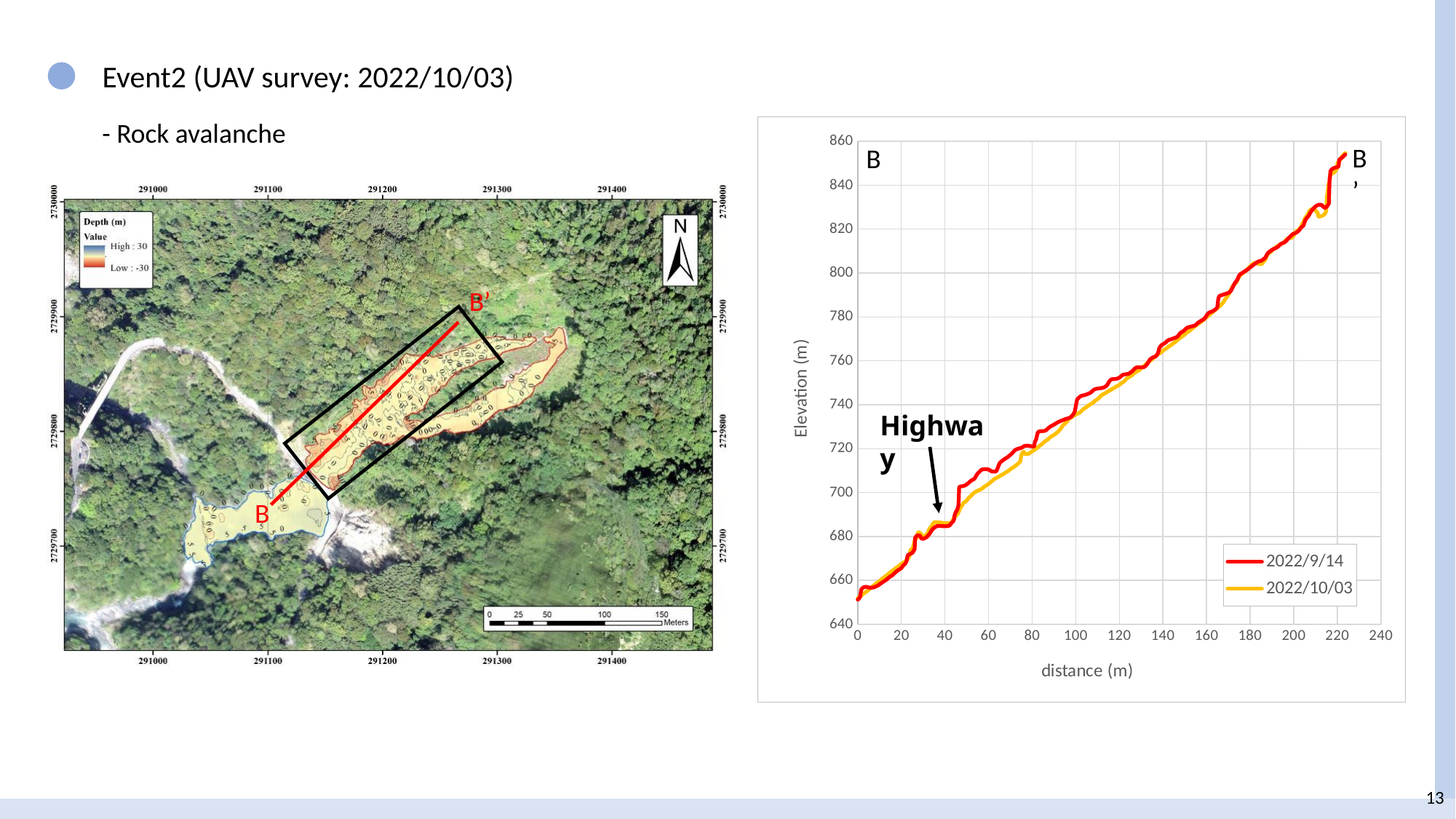
How many series does the legend of the elevation profile chart list? 2 In the elevation profile chart, is the elevation of the 2022/9/14 line at distance 0 greater or less than 660? less What are the two series named in the legend of the elevation profile chart? 2022/9/14 and 2022/10/03 In the elevation profile chart, is the elevation of the 2022/9/14 line at distance 220 greater or less than 840? greater In the elevation profile chart, do the elevation values rise or fall as distance increases? rise In the elevation profile chart, at distance 60 m, which series has the higher elevation, 2022/9/14 or 2022/10/03? 2022/9/14 In the elevation profile chart, is the elevation of the 2022/10/03 line at distance 60 greater or less than 700? greater What kind of chart is shown on the right side of the slide? line chart What is the highest tick value shown on the y axis of the elevation profile chart? 860 What is the label of the y axis of the elevation profile chart? Elevation (m)